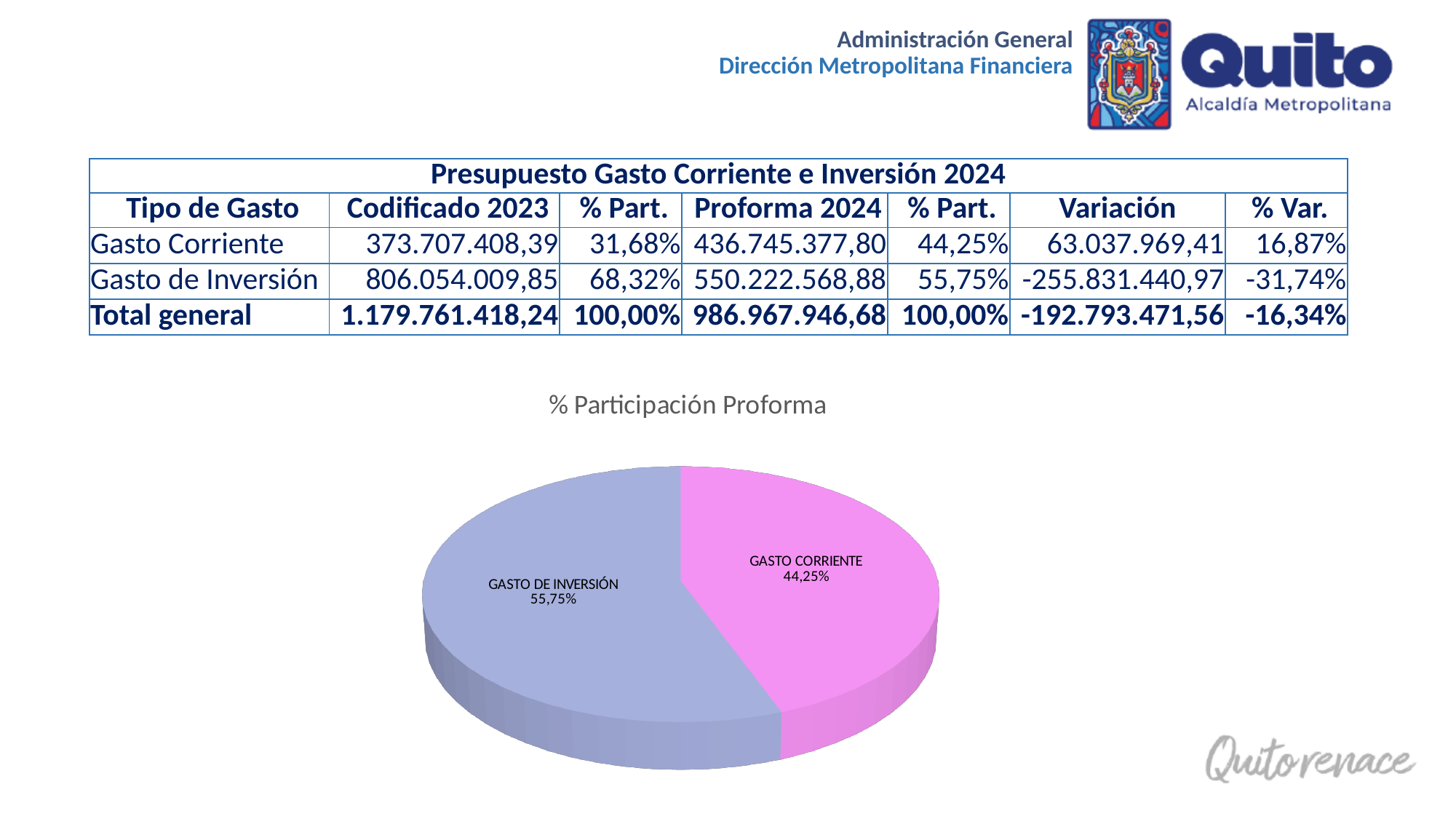
Which slice of the pie is the smallest? GASTO CORRIENTE What share of the pie does GASTO DE INVERSIÓN represent? 55,75% What is the total of the two slices shown in the pie chart? 100,00% What is the title of the chart? % Participación Proforma Which is larger, the GASTO CORRIENTE slice or the GASTO DE INVERSIÓN slice? GASTO DE INVERSIÓN What share of the pie does GASTO CORRIENTE represent? 44,25% Is the share for GASTO CORRIENTE greater or less than 50%? less How many slices does the pie chart have? 2 What colour is the GASTO CORRIENTE slice? pink What is the difference in percentage points between the GASTO DE INVERSIÓN slice and the GASTO CORRIENTE slice? 11,50% Which slice of the pie is the largest? GASTO DE INVERSIÓN What type of chart is shown on the slide? pie chart